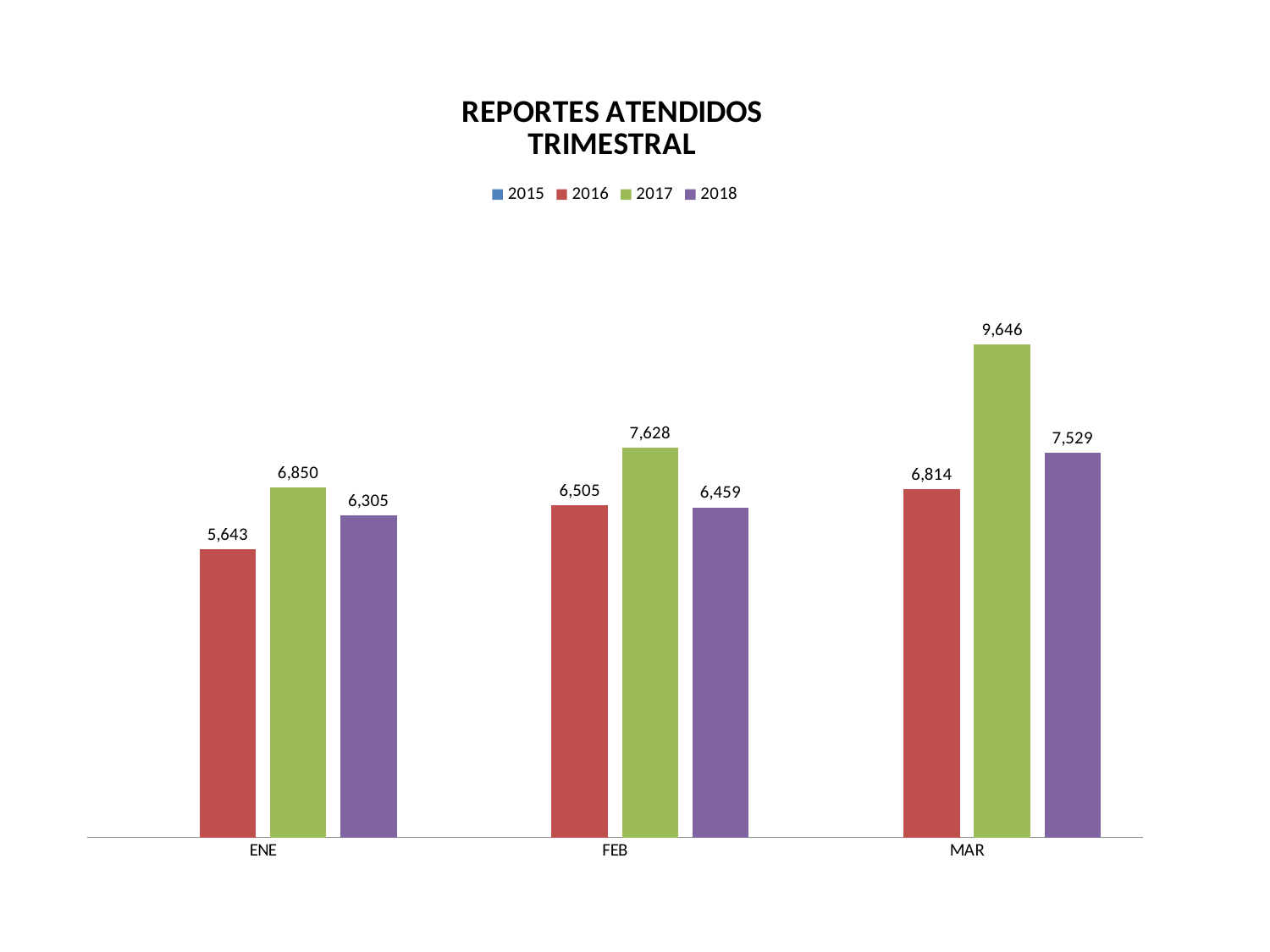
What is the value for 2017 in MAR? 9,646 What kind of chart is shown on the slide? Bar chart Which month has the highest value for 2017? MAR Do the values for 2017 rise or fall from ENE to MAR? Rise Which month has the lowest value for 2016? ENE What is the value for 2016 in ENE? 5,643 How many series does the legend list? 4 How many months are shown on the x axis? 3 What is the difference between the 2017 and 2016 values in MAR? 2,832 What is the difference between the 2017 and 2018 values in ENE? 545 What is the value for 2018 in FEB? 6,459 Which is larger in FEB, the value for 2016 or the value for 2018? 2016